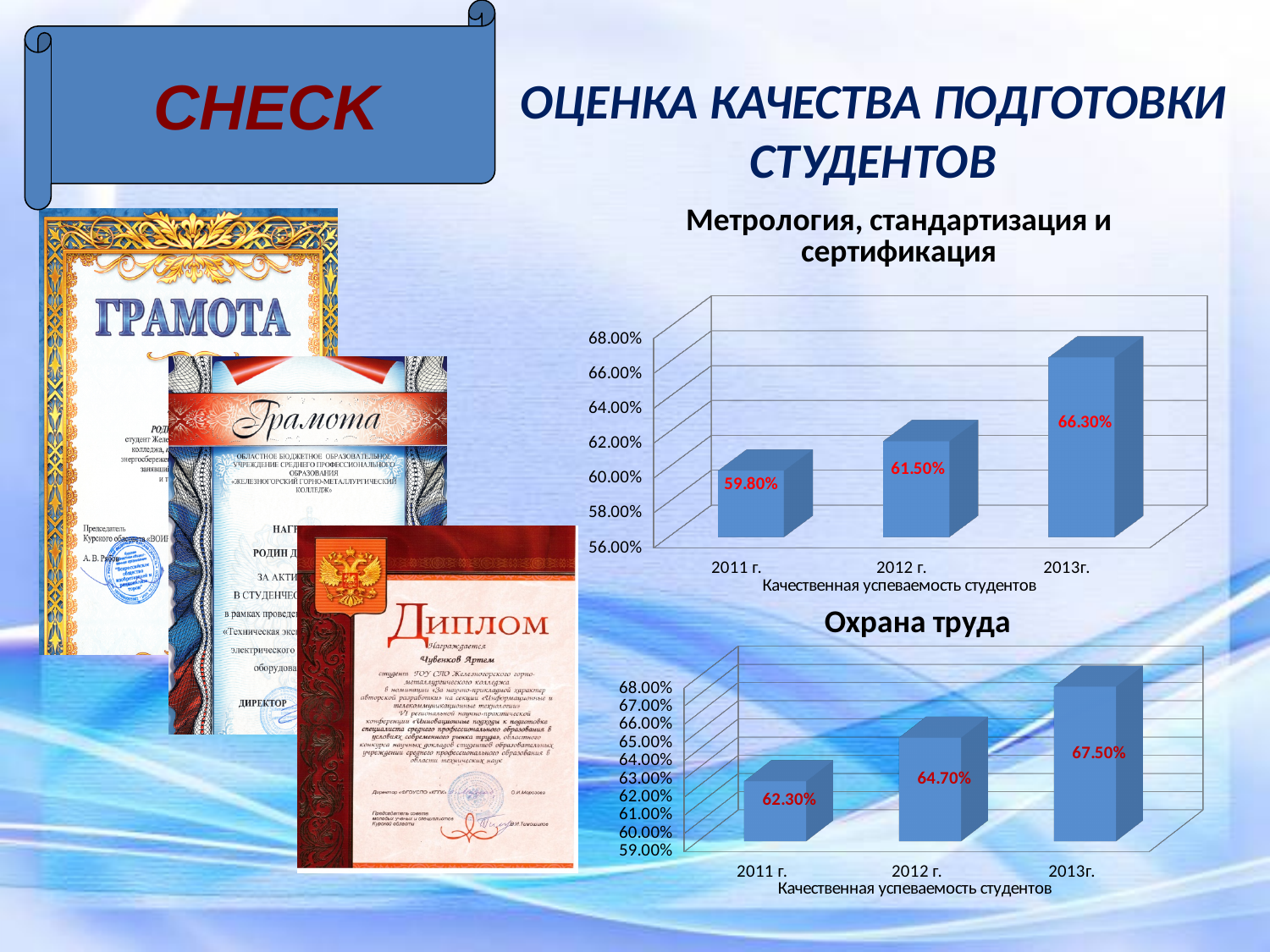
In the chart titled "Охрана труда", what is the value for 2012 г.? 64.70% In the chart titled "Охрана труда", which is larger: the value for 2011 г. or the value for 2013г.? 2013г. In the chart titled "Охрана труда", what is the value for 2013г.? 67.50% In the chart titled "Метрология, стандартизация и сертификация", what is the value for 2013г.? 66.30% In the chart titled "Охрана труда", what is the difference between the values for 2012 г. and 2011 г.? 2.40% In the chart titled "Метрология, стандартизация и сертификация", do the values rise or fall from 2011 г. to 2013г.? rise In the chart titled "Метрология, стандартизация и сертификация", which year has the highest value? 2013г. What kind of chart is the chart titled "Метрология, стандартизация и сертификация"? bar chart In the chart titled "Метрология, стандартизация и сертификация", what is the value for 2011 г.? 59.80% In the chart titled "Метрология, стандартизация и сертификация", what is the difference between the values for 2013г. and 2012 г.? 4.80% How many categories are shown in the chart titled "Охрана труда"? 3 In the chart titled "Охрана труда", which year has the lowest value? 2011 г.